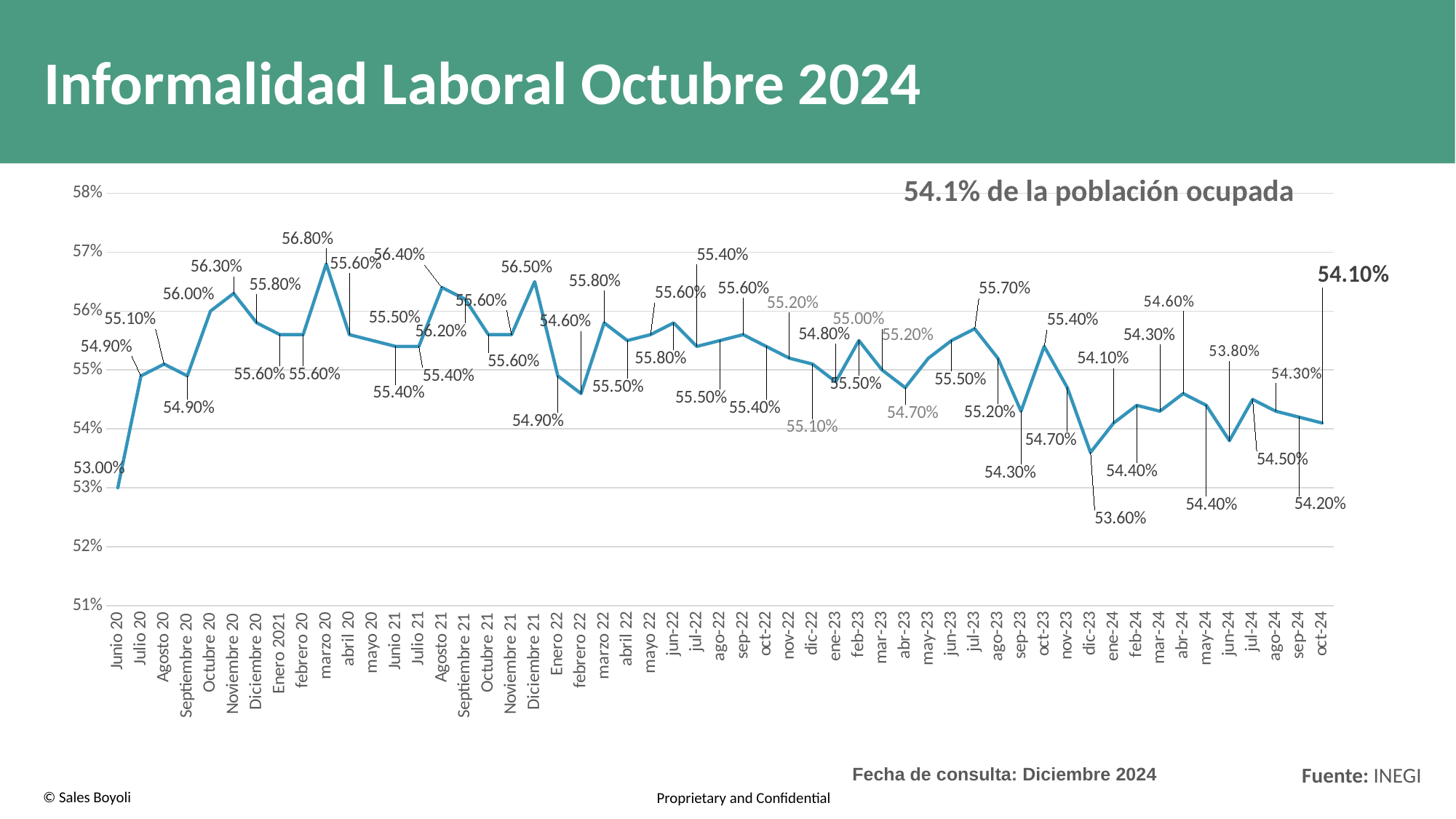
What is the value for dic-23? 53.60% What is the title of the slide? Informalidad Laboral Octubre 2024 What is the difference between the value for oct-24 and the value for dic-23? 0.50 percentage points What is the value for Junio 20? 53.00% Which month has the highest value on the chart? marzo 20 (56.80%) Which month has the lowest value on the chart? Junio 20 (53.00%) What is the value for oct-24? 54.10% From jul-23 to dic-23, does the value generally rise or fall? fall What is the source cited for the chart data? INEGI What kind of chart is shown on the slide? line chart Which is larger, the value for jul-23 or the value for sep-23? jul-23 Is the value for jun-24 greater or less than 54%? less